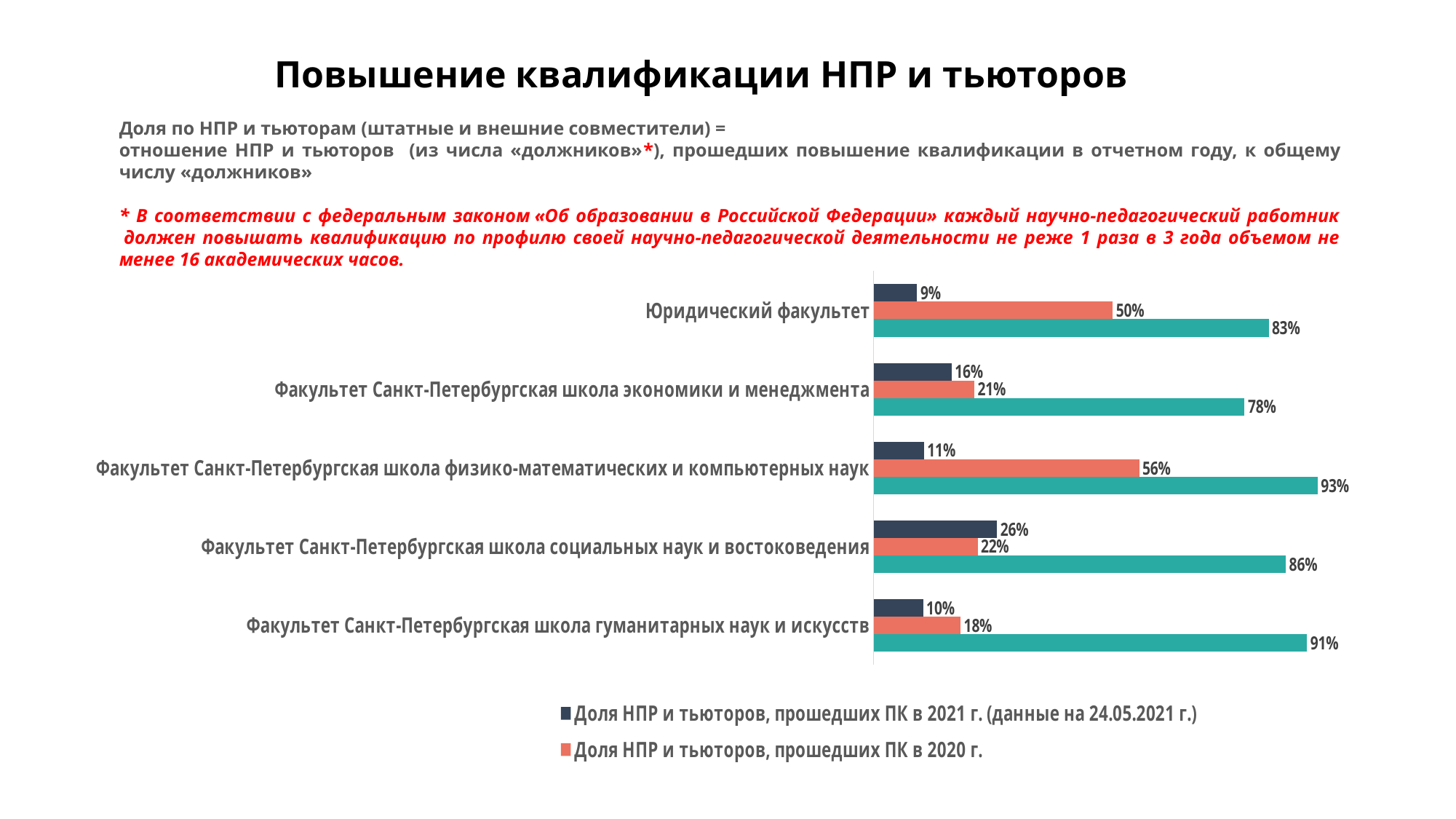
What is the 2021 value for Факультет Санкт-Петербургская школа экономики и менеджмента? 16% For Юридический факультет, what is the difference between the 2020 value and the 2021 value? 41 percentage points What is the share of NPR and tutors who completed professional development in 2021 for Юридический факультет? 9% What type of chart is shown on the slide? Bar chart How many faculties are shown on the chart? 5 Which faculty has the lowest 2021 value? Юридический факультет What is the 2020 value for Факультет Санкт-Петербургская школа физико-математических и компьютерных наук? 56% Which faculty has the lowest 2020 value? Факультет Санкт-Петербургская школа гуманитарных наук и искусств Which faculty has the highest share of NPR and tutors who completed professional development in 2021? Факультет Санкт-Петербургская школа социальных наук и востоковедения Which faculty has the highest 2020 value? Факультет Санкт-Петербургская школа физико-математических и компьютерных наук For Факультет Санкт-Петербургская школа социальных наук и востоковедения, which is larger: the 2021 value or the 2020 value? 2021 value How many series does the legend list? 2